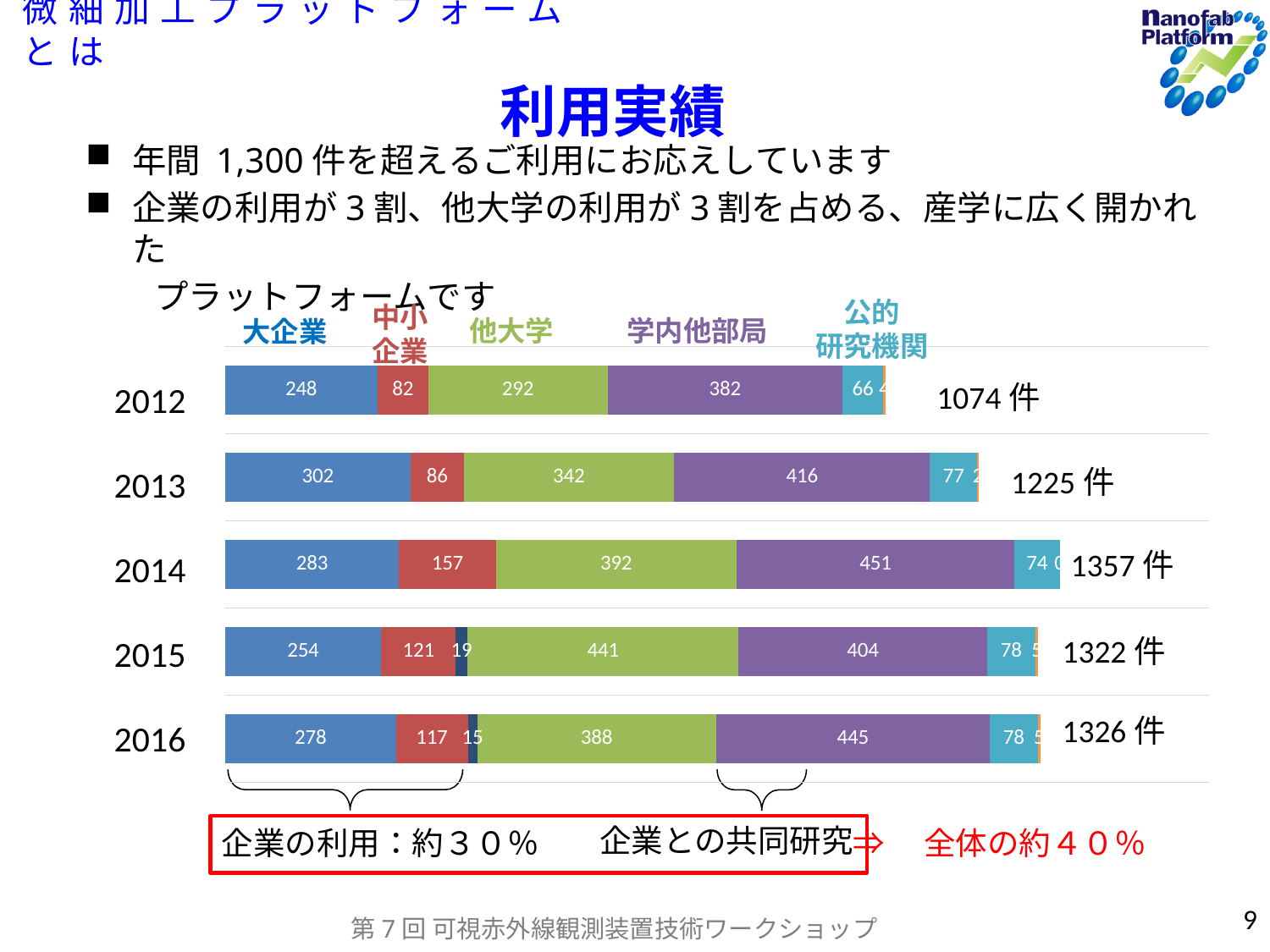
Which year has the lowest total number of cases? 2012 What is the value for 大企業 in 2014? 283 What kind of chart is shown on the slide? Stacked bar chart What is the value for 他大学 in 2015? 441 What is the value for 中小企業 in 2016? 117 What is the value for 学内他部局 in 2013? 416 What is the difference between the 大企業 values for 2013 and 2012? 54 What is the total number of cases shown for 2012? 1074 件 How many series labels are shown above the chart? 5 How many years are shown in the chart? 5 Which is larger in 2016, the value for 他大学 or the value for 学内他部局? 学内他部局 Which year has the highest total number of cases? 2014